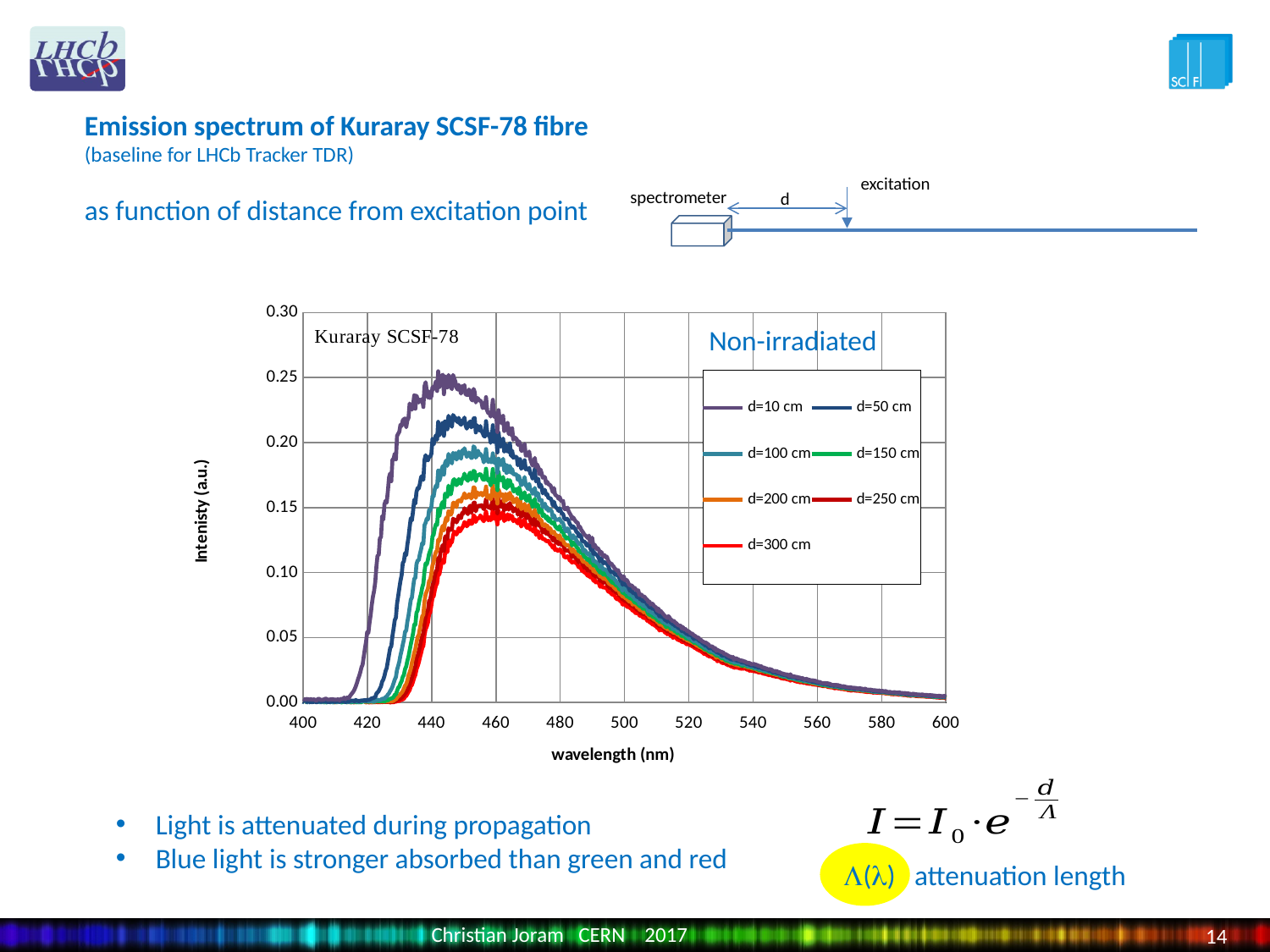
What is the label of the x axis of the chart? wavelength (nm) Is the intensity of the d=10 cm series at 540 nm greater or less than 0.10? less Is the peak intensity of the d=300 cm series greater or less than 0.10? greater How many series does the legend of the chart list? 7 Which series has the higher peak intensity, d=10 cm or d=300 cm? d=10 cm Is the peak intensity of the d=10 cm series greater or less than 0.20? greater Which series is listed last in the chart's legend? d=300 cm Which series has the higher peak intensity, d=50 cm or d=200 cm? d=50 cm Do the intensity values rise or fall as the wavelength increases from 500 nm to 600 nm? fall Which series reaches the highest peak intensity in the chart? d=10 cm What kind of chart is shown on the slide? line chart